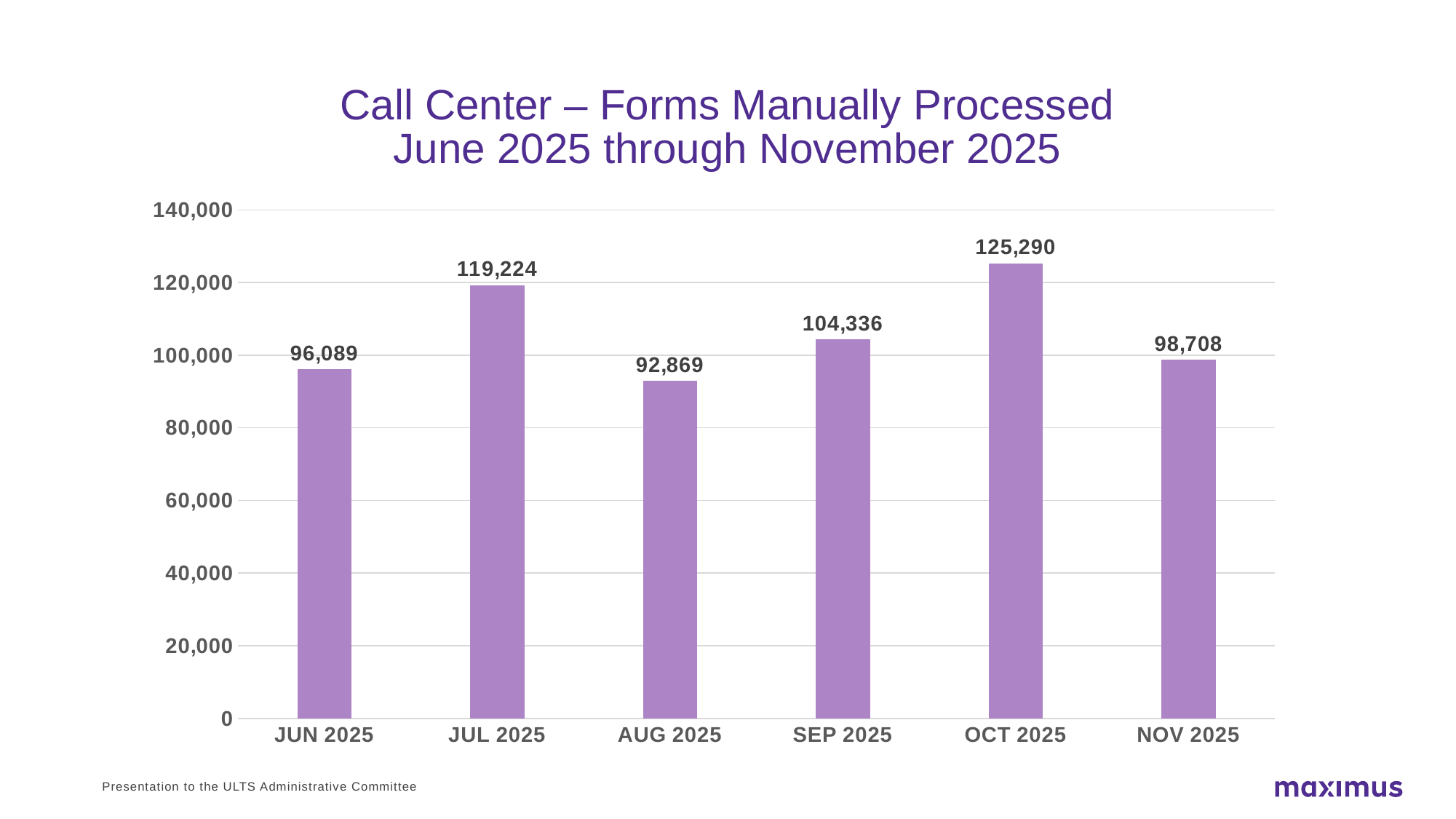
What is the value for JUL 2025? 119,224 Which is larger, the value for JUN 2025 or the value for NOV 2025? NOV 2025 What is the title of the chart? Call Center – Forms Manually Processed June 2025 through November 2025 Is the value for SEP 2025 greater or less than 100,000? greater What is the difference between the values for OCT 2025 and AUG 2025? 32,421 What is the value for NOV 2025? 98,708 What is the difference between the values for JUL 2025 and JUN 2025? 23,135 What kind of chart is shown on the slide? bar chart Which month has the highest value? OCT 2025 Which month has the lowest value? AUG 2025 What is the value for SEP 2025? 104,336 How many months are shown on the x axis? 6